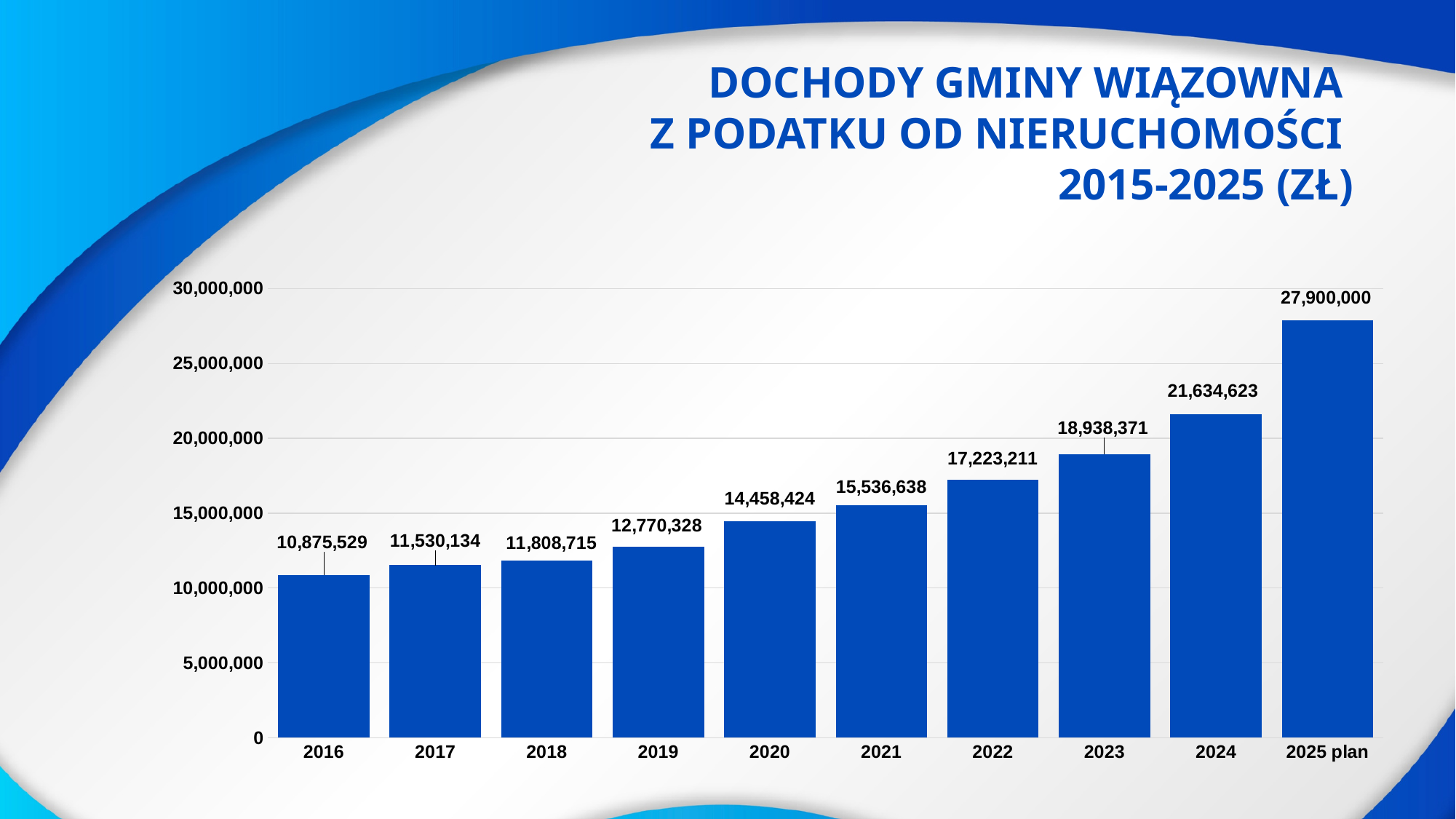
Do the values rise or fall from 2016 to 2025 plan? rise Which year has the highest value? 2025 plan What is the difference between the 2017 value and the 2016 value? 654,605 What is the value for 2025 plan? 27,900,000 Which is larger, the value for 2022 or the value for 2021? 2022 What is the value for 2020? 14,458,424 What kind of chart is shown on the slide? bar chart Which year has the lowest value? 2016 What is the value for 2016? 10,875,529 How many bars are shown in the chart? 10 What is the difference between the 2025 plan value and the 2024 value? 6,265,377 Is the value for 2023 greater or less than 20,000,000? less